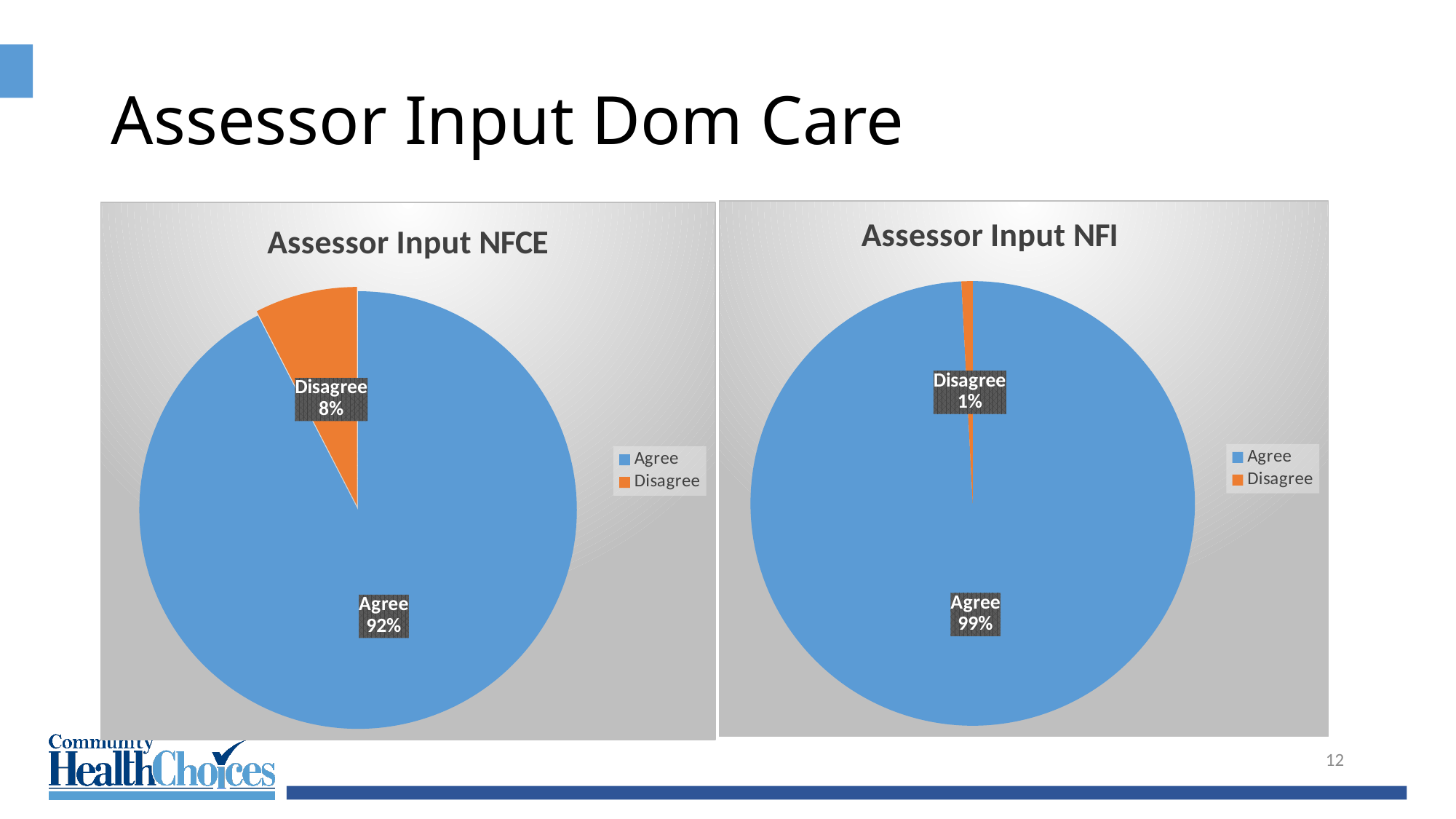
In the 'Assessor Input NFCE' chart, what colour is the Disagree slice? Orange Which chart has the larger Disagree share, 'Assessor Input NFCE' or 'Assessor Input NFI'? Assessor Input NFCE In the 'Assessor Input NFI' chart, what percentage is shown for Disagree? 1% In the 'Assessor Input NFI' chart, which slice is the smallest? Disagree How many entries does the legend of the 'Assessor Input NFI' chart list? 2 In the 'Assessor Input NFCE' chart, which slice is the largest? Agree How many slices does the 'Assessor Input NFCE' pie chart have? 2 In the 'Assessor Input NFI' chart, what percentage is shown for Agree? 99% What type of chart is 'Assessor Input NFI'? Pie chart In the 'Assessor Input NFCE' chart, what is the difference between the Agree and Disagree percentages? 84% In the 'Assessor Input NFCE' chart, what percentage is shown for Agree? 92% In the 'Assessor Input NFCE' chart, what percentage is shown for Disagree? 8%